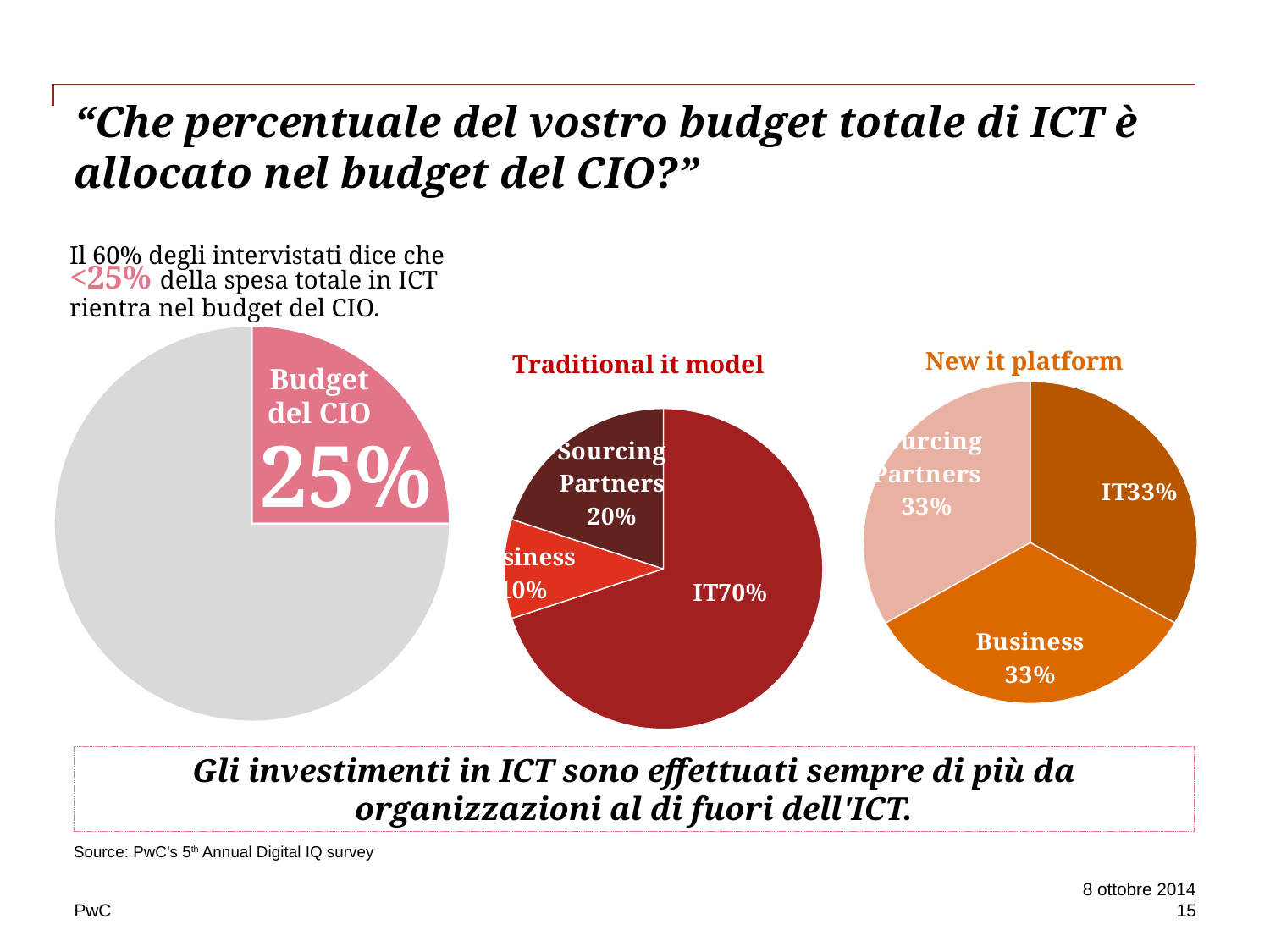
How many slices does the "Traditional it model" pie chart have? 3 In the "Traditional it model" pie chart, what percentage is shown for Sourcing Partners? 20% In the "New it platform" pie chart, what percentage is shown for IT? 33% Is the IT share larger in the "Traditional it model" chart or in the "New it platform" chart? Traditional it model How many slices does the "New it platform" pie chart have? 3 In the "Traditional it model" pie chart, what percentage is shown for IT? 70% In the leftmost pie chart, what share of the pie is labelled "Budget del CIO"? 25% What is the title of the middle pie chart on the slide? Traditional it model In the "Traditional it model" pie chart, which category has the largest slice? IT In the "Traditional it model" pie chart, what is the difference between the IT share and the Sourcing Partners share? 50 percentage points In the "New it platform" pie chart, what percentage is shown for Business? 33% What kind of chart is the "Traditional it model" chart? Pie chart